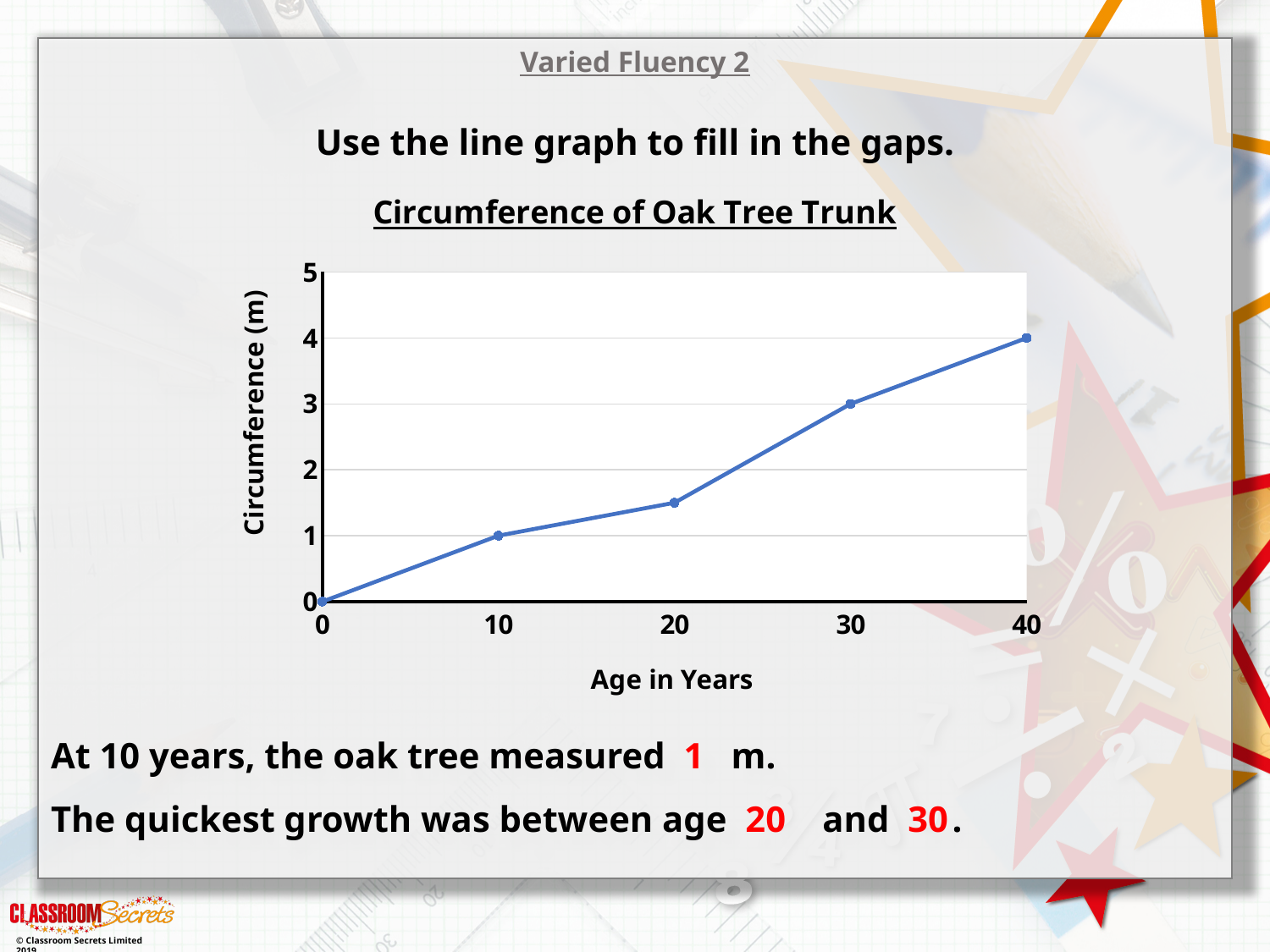
Is the circumference at 20 years greater or less than 2? less How many data points are plotted on the line graph? 5 What is the difference in circumference between 40 years and 10 years? 3 At which age is the circumference highest? 40 Does the circumference rise or fall as age increases? rises At which age is the circumference lowest? 0 What is the circumference of the oak tree trunk at 0 years? 0 What is the circumference of the oak tree trunk at 10 years? 1 What is the circumference of the oak tree trunk at 40 years? 4 What is the circumference of the oak tree trunk at 30 years? 3 What kind of chart is shown on the slide? line chart What is the label on the vertical axis of the chart? Circumference (m)